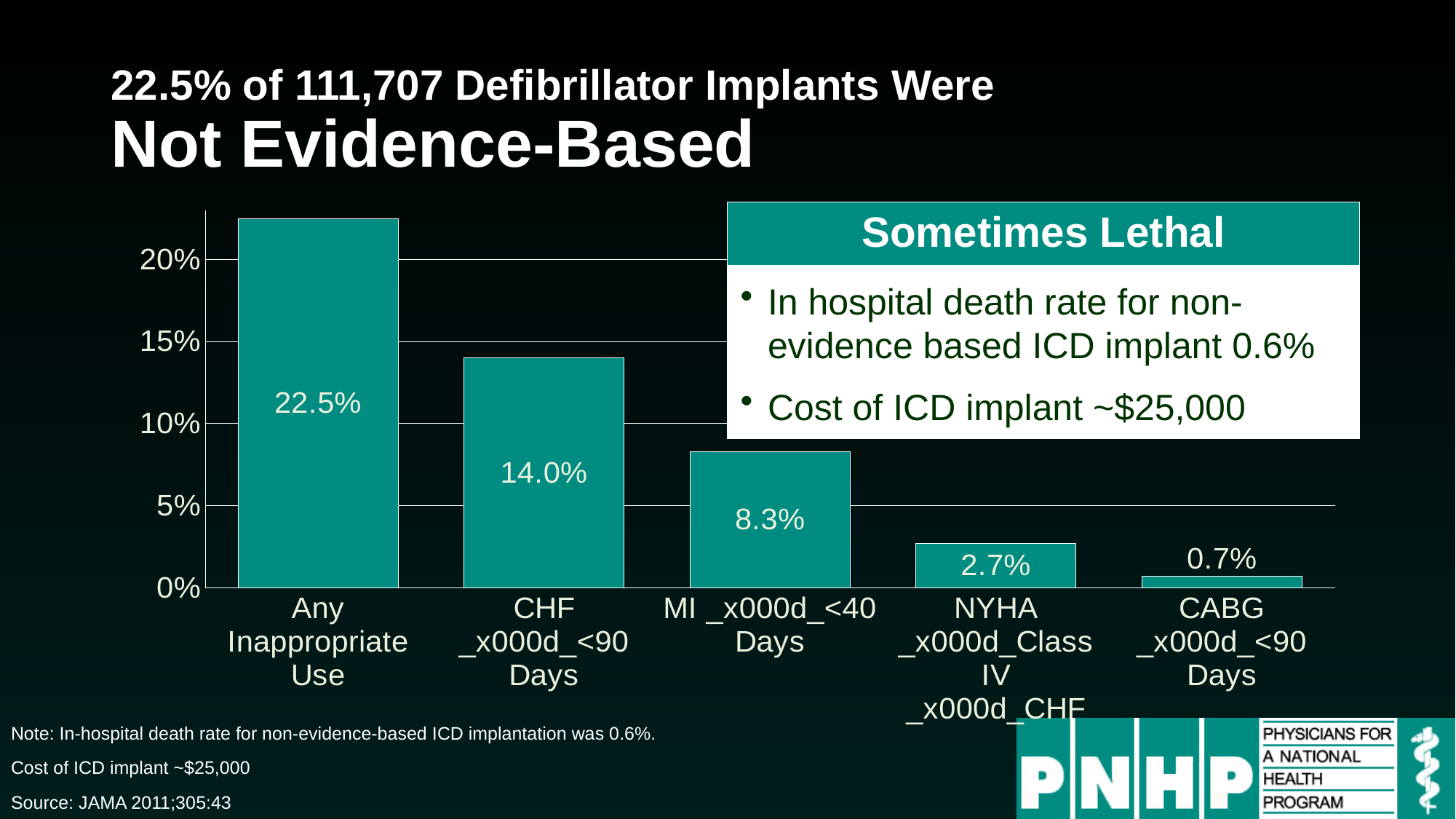
Which is larger, the value for MI <40 Days or the value for NYHA Class IV CHF? MI <40 Days What is the value for NYHA Class IV CHF? 2.7% What is the difference between the values for CHF <90 Days and MI <40 Days? 5.7% Which category has the lowest value? CABG <90 Days What is the value for Any Inappropriate Use? 22.5% What is the value for CHF <90 Days? 14.0% Which category has the highest value? Any Inappropriate Use How many categories are shown in the chart? 5 What is the value for MI <40 Days? 8.3% What kind of chart is shown on the slide? Bar chart Do the values rise or fall from left to right along the x axis? Fall What is the value for CABG <90 Days? 0.7%